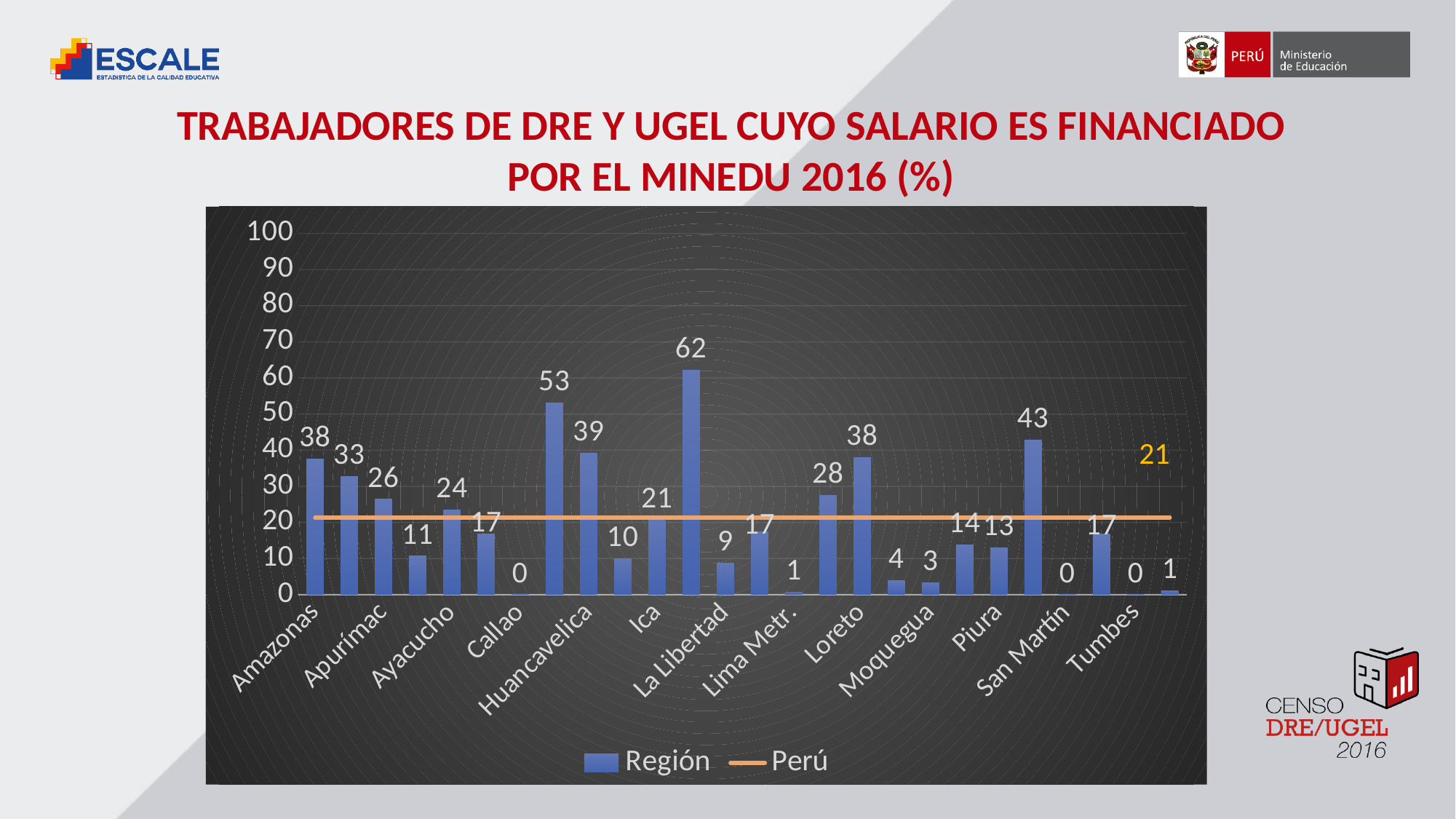
What is the value of the Perú line? 21 Which is larger, the value for Apurímac or the value for Ayacucho? Apurímac What is the difference between the values for Loreto and Piura? 25 Is the value for Ica greater or less than the value for Moquegua? greater What is the value for Lima Metr.? 1 What is the difference between the value for Huancavelica and the Perú line value? 18 What is the value for La Libertad? 9 What kind of chart is this? bar chart What is the value for Huancavelica? 39 What is the value for Amazonas? 38 What are the two legend entries? Región and Perú How many series does the legend list? 2